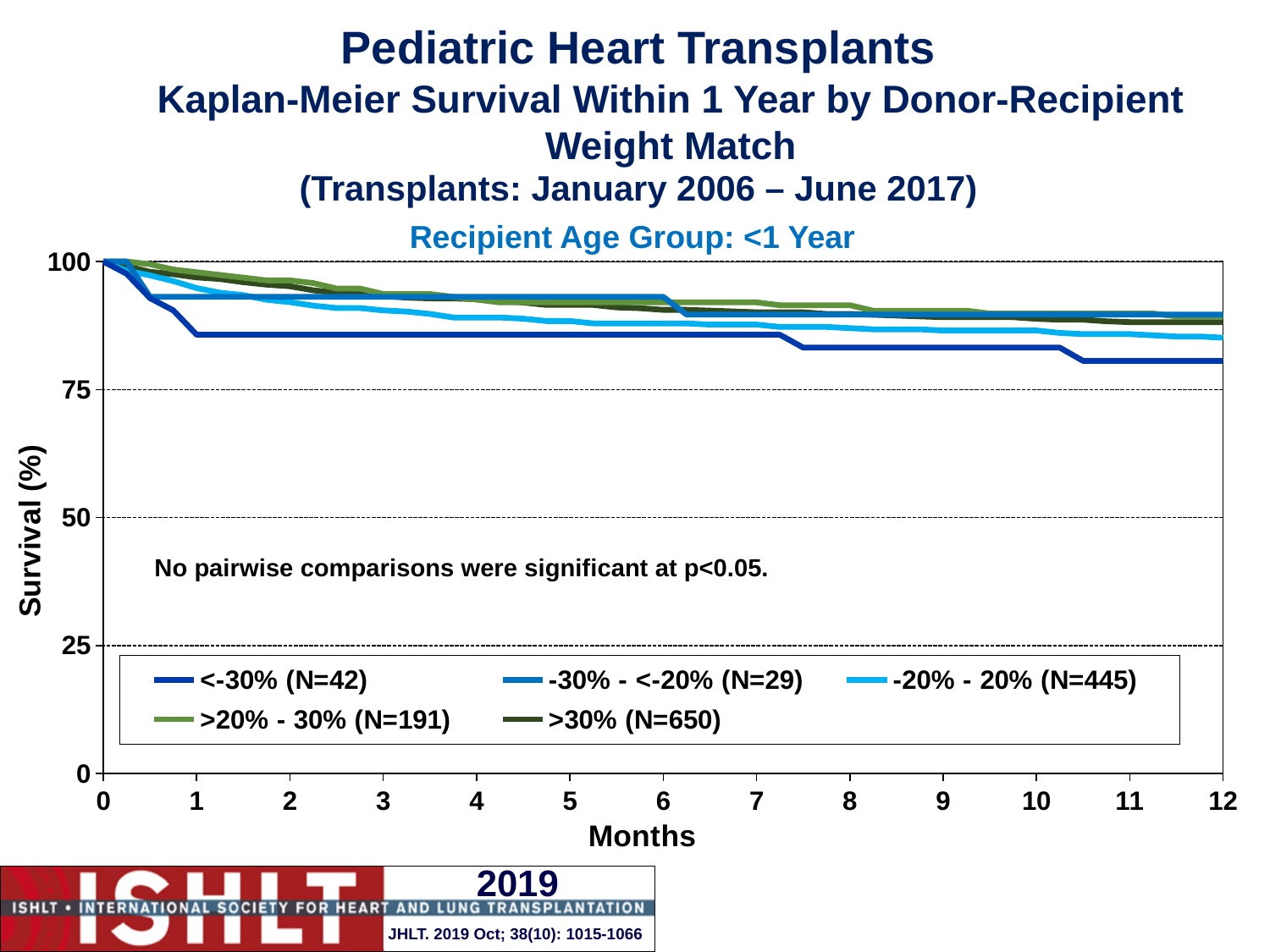
What is the N for the -20% - 20% weight match group shown in the legend? 445 What does the annotation on the chart say about pairwise comparisons? No pairwise comparisons were significant at p<0.05. How many series does the legend list? 5 Is the survival for the -20% - 20% group at 6 months greater or less than 75? greater Which weight match group has the largest N in the legend? >30% (N=650) Which weight match group has the smallest N in the legend? -30% - <-20% (N=29) Which weight match group has the lowest survival at 12 months? <-30% What is the N for the >30% weight match group shown in the legend? 650 Do the survival curves rise or fall as months increase? Fall Is the survival for the <-30% group at 12 months greater or less than 75? greater What is the recipient age group shown in the chart subtitle? <1 Year What kind of chart is shown on the slide? Line chart